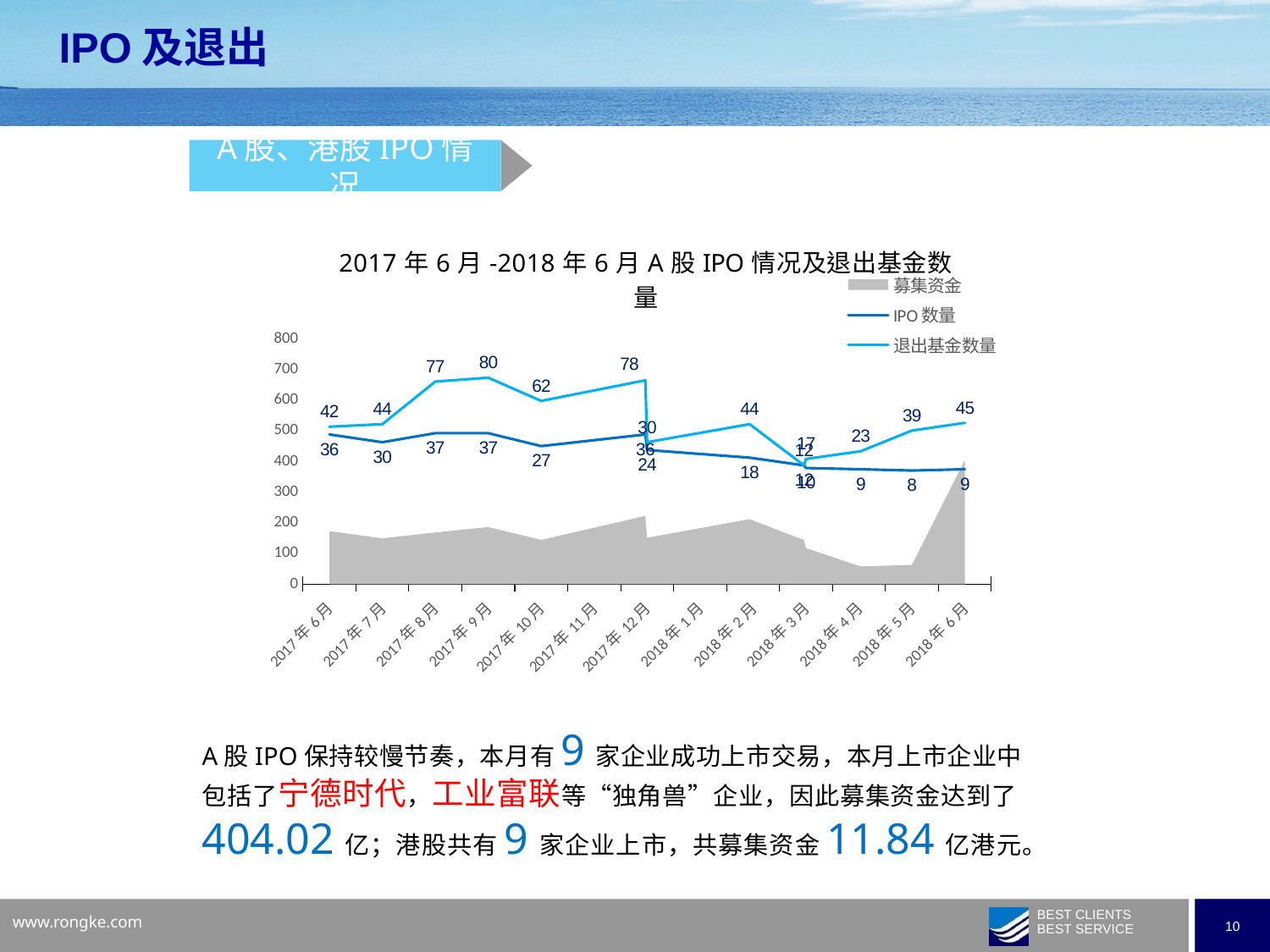
What is the 退出基金数量 value for 2018年6月? 45 What is the 退出基金数量 value for 2017年6月? 42 Which month has the larger 退出基金数量 value, 2017年7月 or 2017年8月? 2017年8月 In which month is 退出基金数量 highest? 2017年9月 What is the IPO数量 value for 2017年6月? 36 What is the difference between the 退出基金数量 values for 2017年9月 and 2017年6月? 38 What is the IPO数量 value for 2018年6月? 9 How many series does the legend list? 3 What are the three series named in the legend? 募集资金, IPO数量, 退出基金数量 How many months are shown on the x axis? 13 What is the title of the chart? 2017年6月-2018年6月A股IPO情况及退出基金数量 Is the 募集资金 value for 2018年6月 greater or less than 300? greater